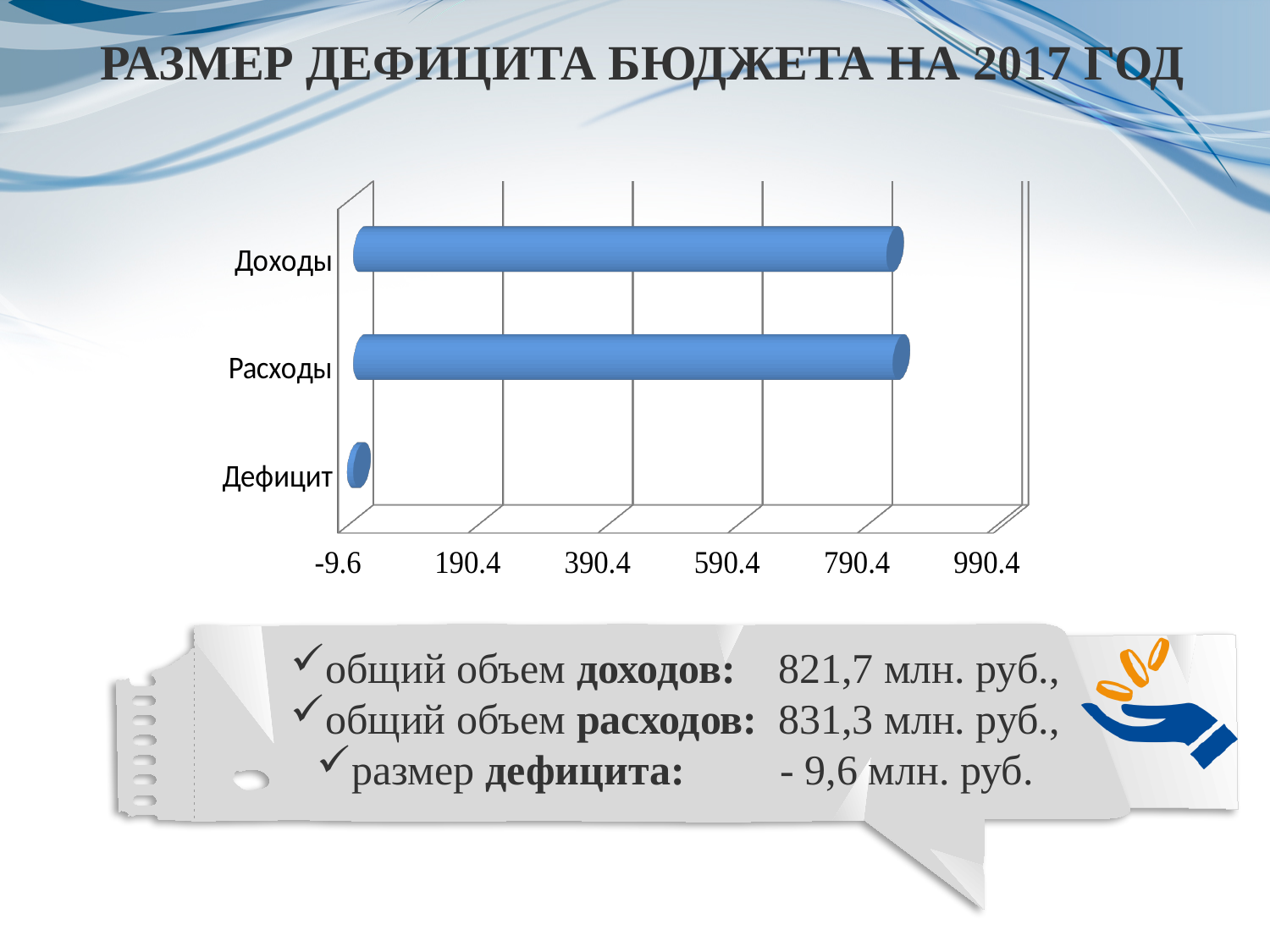
How many categories does the chart show? 3 Which category has the shortest bar in the chart? Дефицит According to the slide, what is the size of the дефицит (deficit)? - 9,6 млн. руб. By how much do расходы exceed доходы according to the values on the slide? 9,6 млн. руб. According to the slide, what is the total volume of расходов (expenditures)? 831,3 млн. руб. What is the highest tick value shown on the horizontal axis of the chart? 990.4 According to the slide, what is the total volume of доходов (revenues)? 821,7 млн. руб. What kind of chart is shown on the slide? bar chart Is the value for Расходы greater or less than 790.4? greater Is the value for Дефицит greater or less than 190.4? less Is the value for Доходы greater or less than 790.4? greater Which category has the longest bar in the chart? Расходы